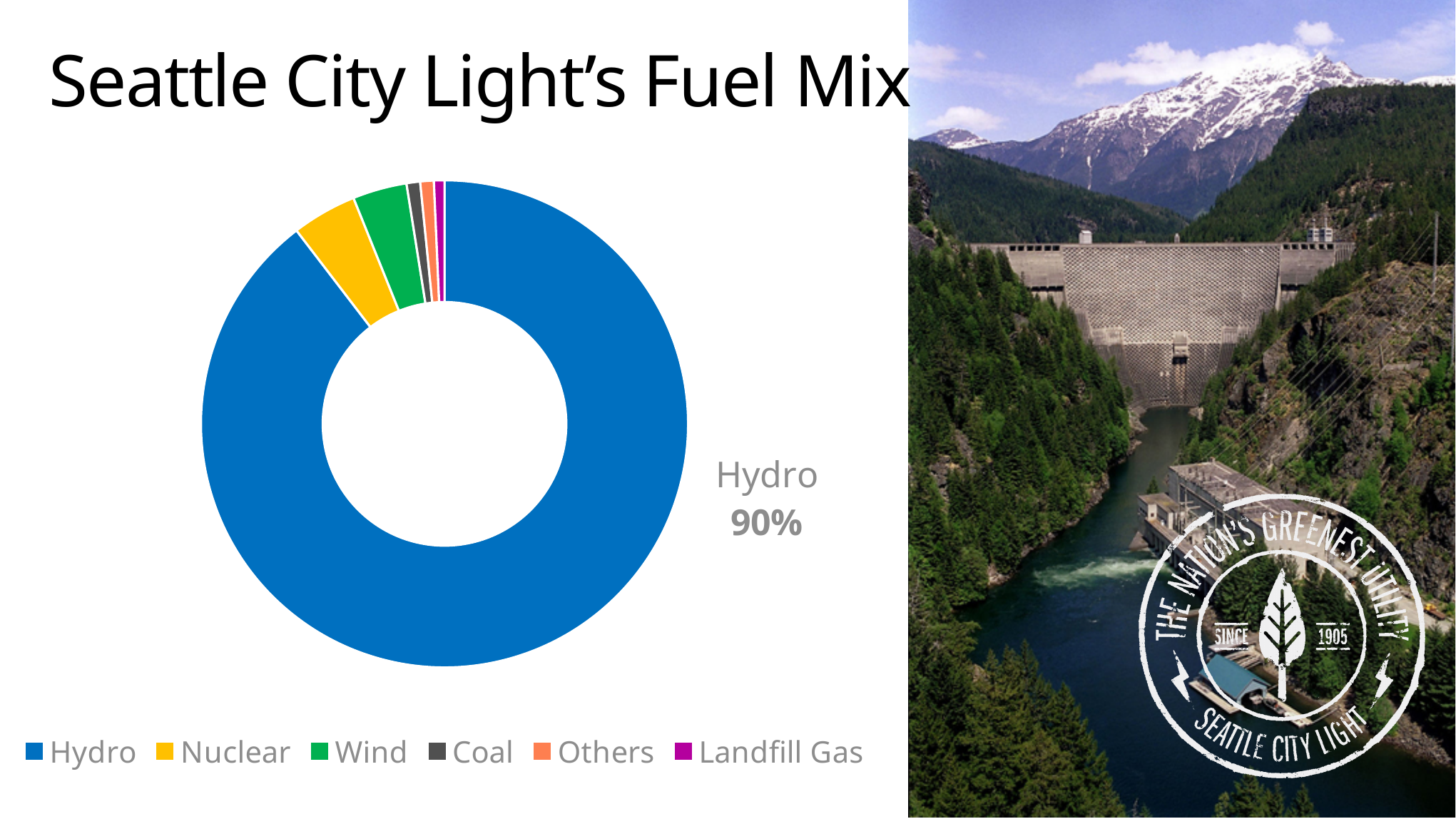
Which is larger in the fuel mix, Nuclear or Landfill Gas? Nuclear Which is larger in the fuel mix, Wind or Coal? Wind What share of Seattle City Light's fuel mix is Hydro? 90% What is the title of the chart on the slide? Seattle City Light's Fuel Mix Which fuel source has the largest share of the fuel mix? Hydro How many fuel categories does the legend list? 6 Which category is shown in yellow in the chart? Nuclear What kind of chart is shown on the slide? Doughnut (pie) chart Is the share for Hydro greater or less than 50%? greater Which is larger in the fuel mix, Hydro or Nuclear? Hydro What colour represents Hydro in the chart? Blue